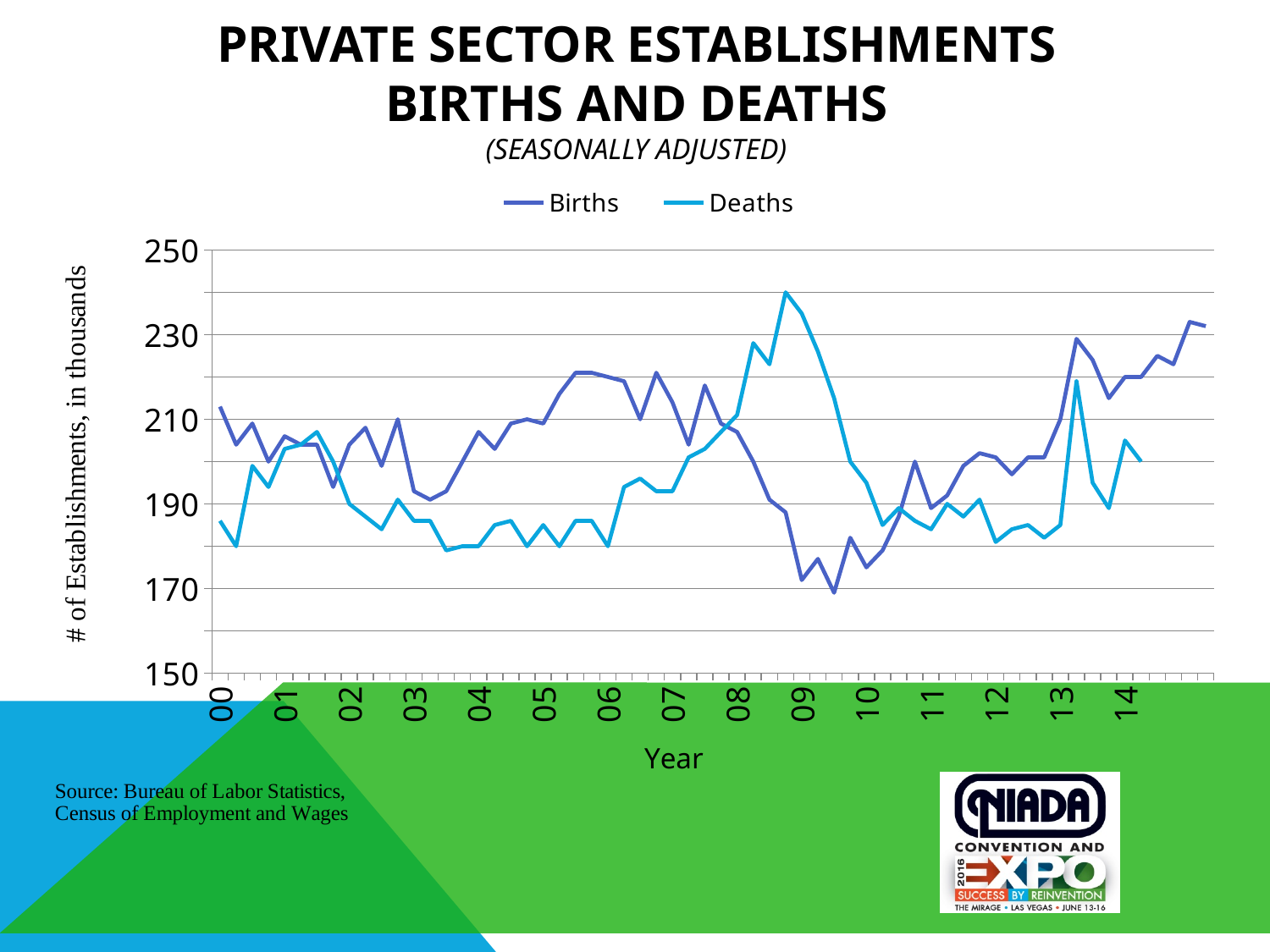
In 2009, which line is higher, Births or Deaths? Deaths Does the Births line generally rise or fall from 2010 to 2014? rise How many year labels are shown along the x axis? 15 What is the label of the vertical axis? # of Establishments, in thousands What are the two series named in the legend? Births and Deaths How many series does the legend list? 2 Is the lowest value of the Births line around 2009 greater or less than 190? less Is the value of the Deaths line at the start of 2000 greater or less than 190? less Is the peak value of the Deaths line around 2008-09 greater or less than 230? greater What kind of chart is shown on the slide? line chart In 2005, which line is higher, Births or Deaths? Births